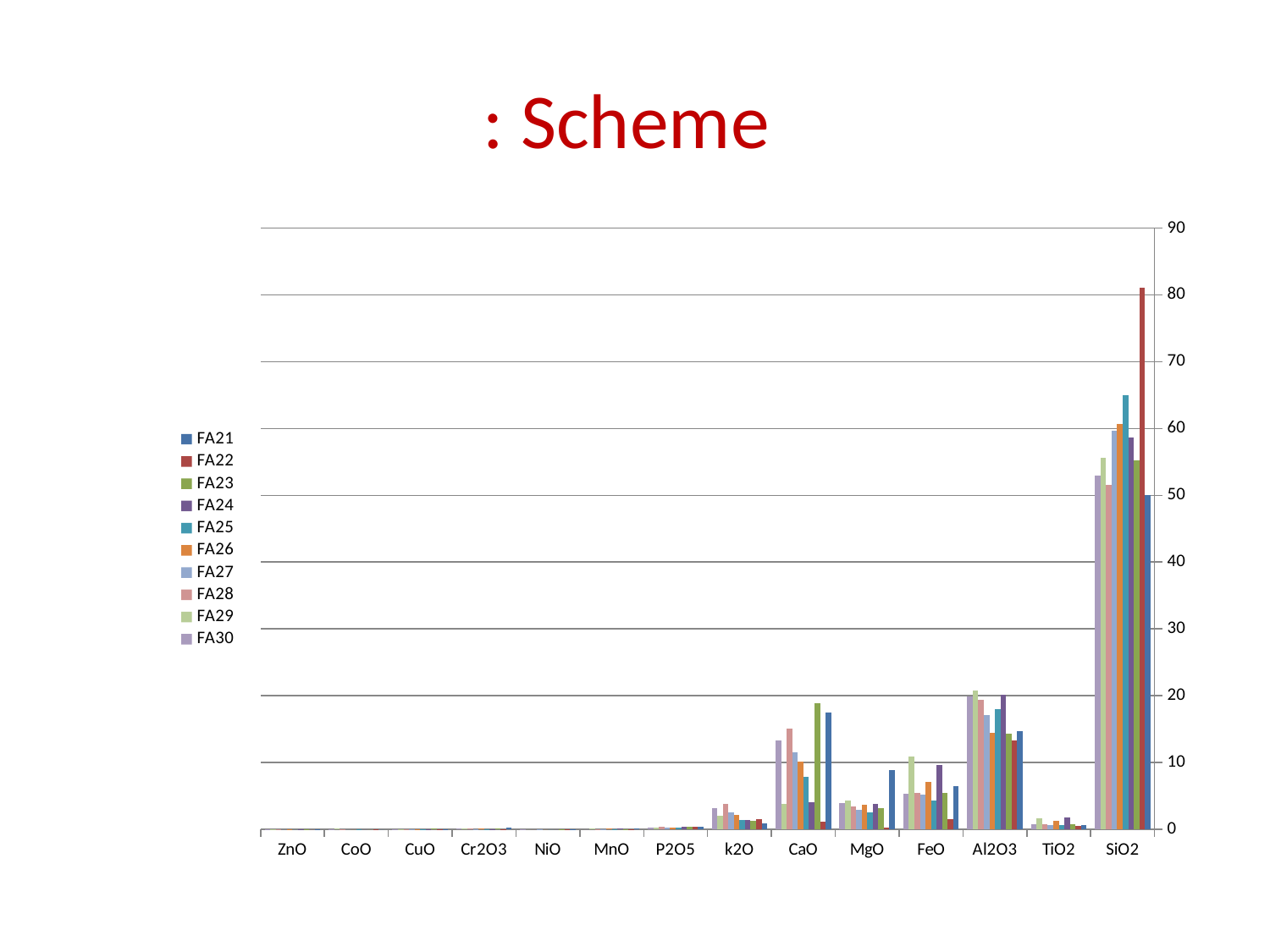
Which is larger for FeO: FA21 or FA22? FA21 Is the value of FA21 for CaO greater or less than 10? greater How many categories are shown along the x axis? 14 What is the first series listed in the legend? FA21 Which series has the highest value for SiO2? FA22 Is the value of FA25 for SiO2 greater or less than 60? greater Is the value of FA22 for SiO2 greater or less than 70? greater Which category has the tallest bars overall? SiO2 What kind of chart is shown on the slide? bar chart Which is larger for SiO2: FA22 or FA21? FA22 How many series does the legend list? 10